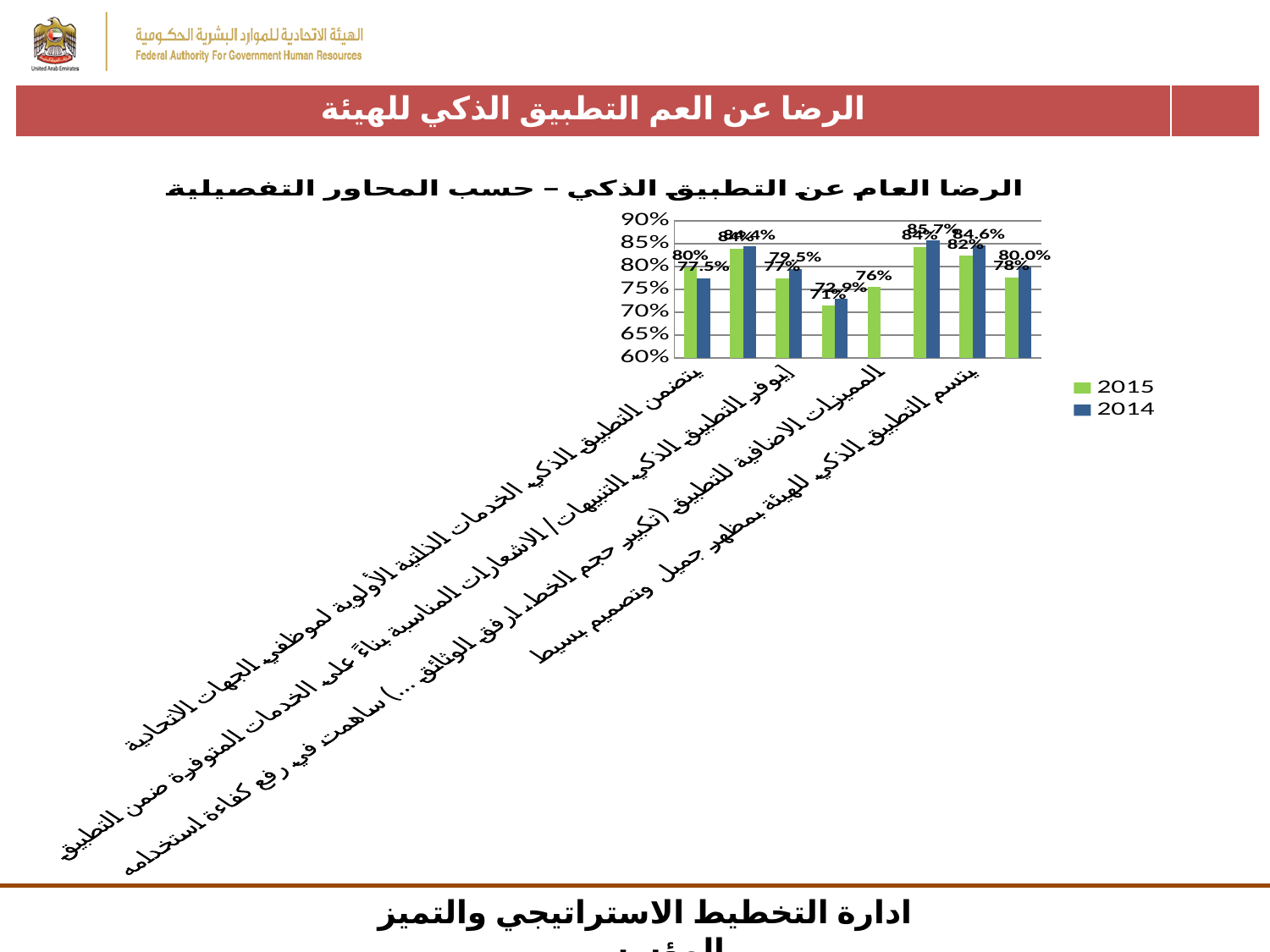
What is the lowest value shown for the 2015 series? 71% What are the two series named in the chart legend? 2015 and 2014 What type of chart is shown on the slide? bar chart In the first (leftmost) group, which series has the larger value, 2015 or 2014? 2015 What is the 2015 value for the fourth group of bars? 71% What is the 2014 value for the first (leftmost) group of bars? 77.5% What is the 2014 value for the fourth group of bars? 72.9% Is the 2015 value for the fourth group of bars greater or less than 75%? less What is the highest value shown for the 2014 series? 85.7% How many series does the chart legend list? 2 In the first (leftmost) group, what is the difference between the 2015 value and the 2014 value? 2.5 percentage points What is the 2015 value for the first (leftmost) group of bars? 80%